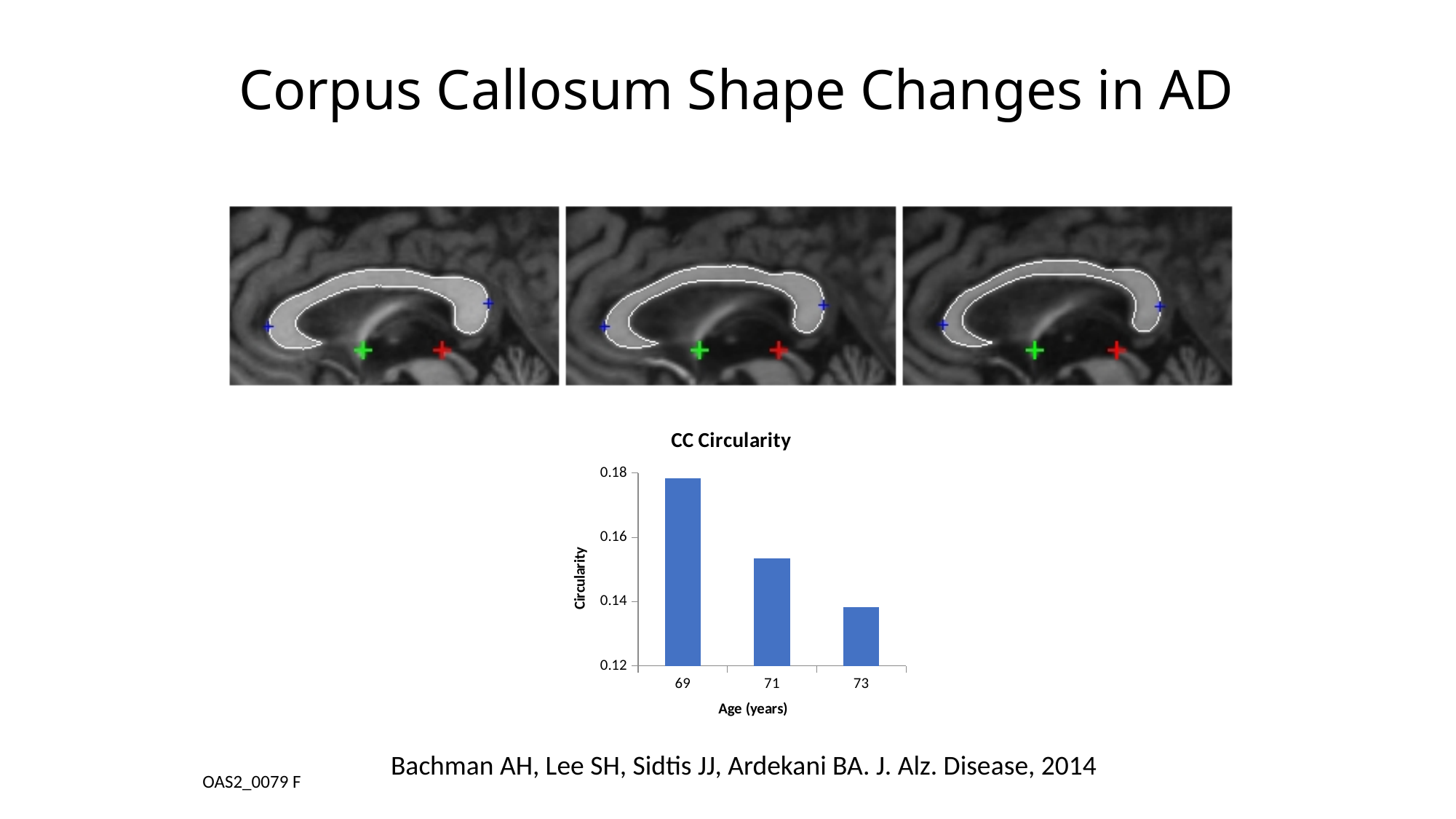
Which age has the lowest circularity in the CC Circularity chart? 73 Which age has the highest circularity in the CC Circularity chart? 69 What is the title of the bar chart on the slide? CC Circularity Do the circularity values rise or fall as age increases in the CC Circularity chart? fall Is the circularity value for age 71 greater or less than 0.16? less Is the circularity value for age 69 greater or less than 0.16? greater In the CC Circularity chart, is the circularity at age 71 or at age 73 larger? 71 What kind of chart is the CC Circularity chart? bar chart What is the x-axis label of the CC Circularity chart? Age (years) How many age categories are shown on the x axis of the CC Circularity chart? 3 In the CC Circularity chart, is the circularity at age 69 or at age 71 larger? 69 Is the circularity value for age 73 greater or less than 0.16? less